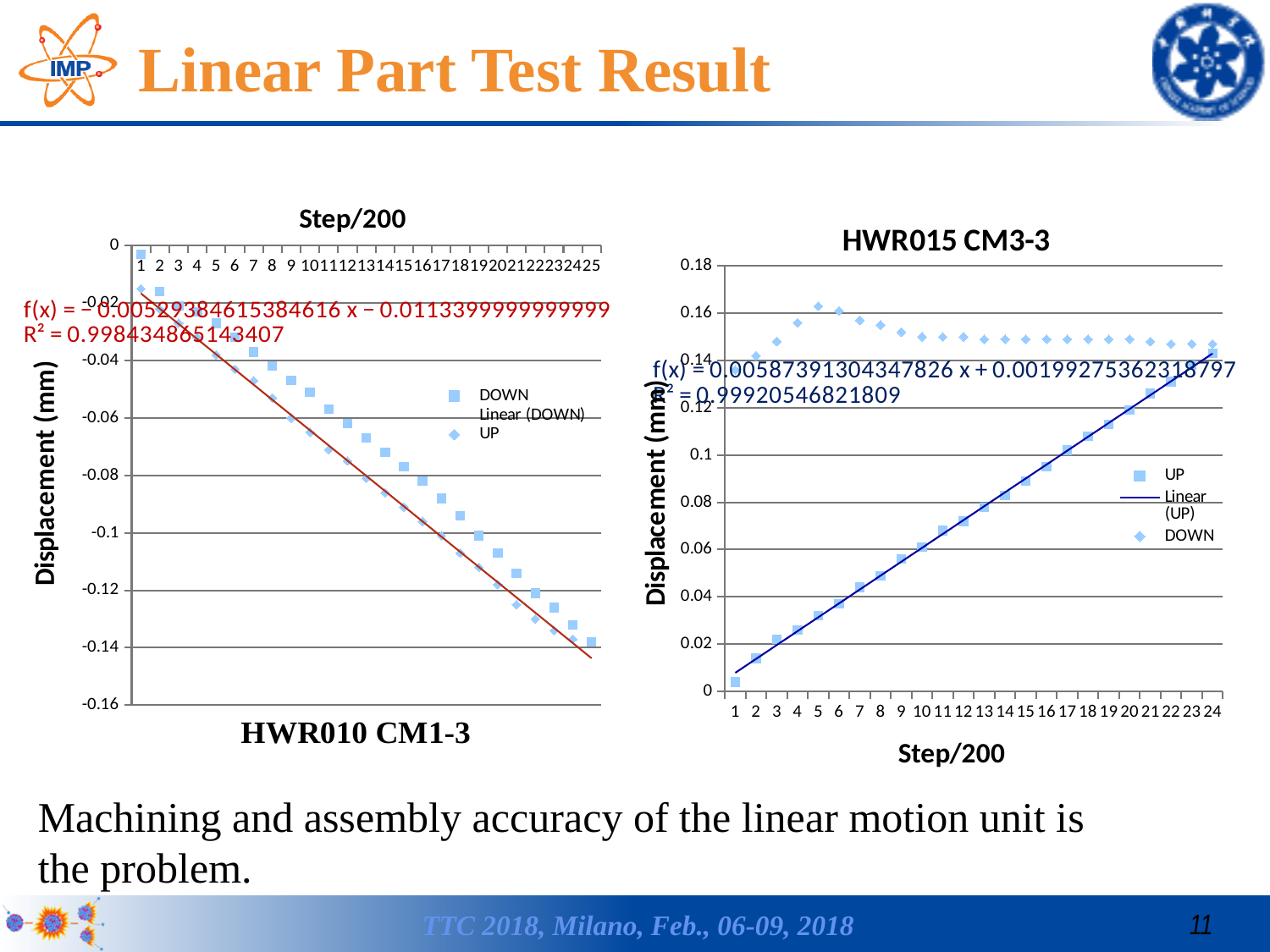
What is the R² value printed on the HWR015 CM3-3 chart? 0.99920546821809 In the HWR010 CM1-3 chart, do the DOWN values rise or fall as the step increases? fall How many series does the legend of the HWR010 CM1-3 chart list? 3 In the HWR015 CM3-3 chart, do the UP values rise or fall as the step increases? rise How many series does the legend of the HWR015 CM3-3 chart list? 3 How many steps are shown on the x axis of the HWR010 CM1-3 chart? 25 What is the R² value printed on the HWR010 CM1-3 chart? 0.998434865143407 How many steps are shown on the x axis of the HWR015 CM3-3 chart? 24 In the HWR015 CM3-3 chart, is the UP value at step 12 greater or less than 0.06? greater In the HWR015 CM3-3 chart, is the DOWN value at step 5 greater or less than 0.14? greater In the HWR015 CM3-3 chart, at step 5, which series has the larger value, UP or DOWN? DOWN What kind of chart is the HWR015 CM3-3 chart on the right? scatter chart